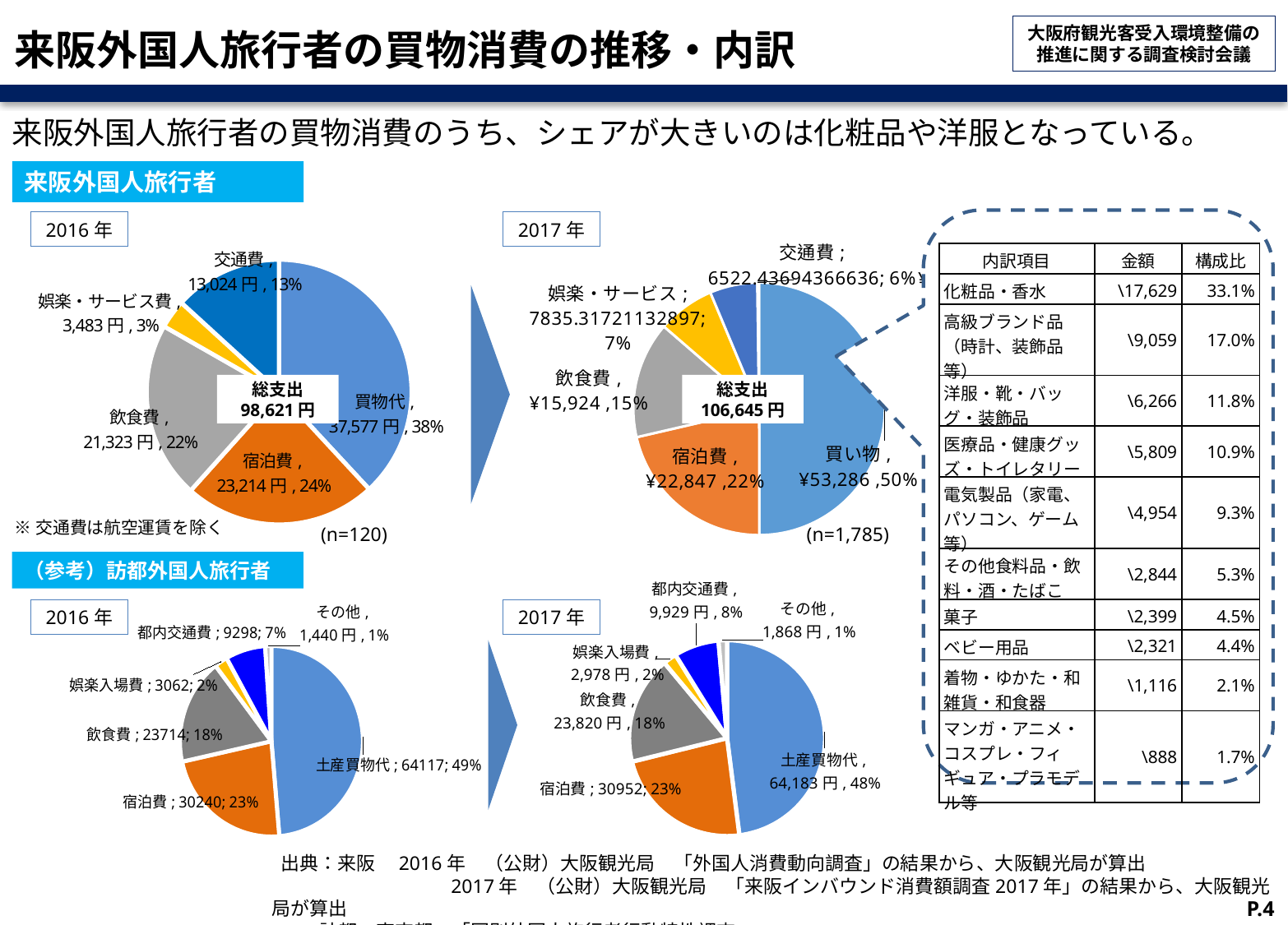
In the 訪都外国人旅行者 2017年 pie chart, what is the value shown for 飲食費? 23,820 円, 18% In the 来阪外国人旅行者 2016年 pie chart, which category has the largest share? 買物代 In the 来阪外国人旅行者 2016年 pie chart, how many categories are shown? 5 In the 来阪外国人旅行者 2016年 pie chart, what is the value shown for 買物代? 37,577 円, 38% In the 訪都外国人旅行者 2016年 pie chart, what is the value shown for 土産買物代? 64117; 49% In the 訪都外国人旅行者 2017年 pie chart, how many categories are shown? 6 In the 訪都外国人旅行者 2017年 pie chart, which is larger, 宿泊費 or 都内交通費? 宿泊費 In the 来阪外国人旅行者 2017年 pie chart, what is the value shown for 宿泊費? ¥22,847, 22% What type of chart is used for the 来阪外国人旅行者 2017年 data? Pie chart In the 来阪外国人旅行者 2017年 pie chart, what share does 買い物 account for? 50% In the 来阪外国人旅行者 2016年 pie chart, what is the 総支出 shown in the centre? 98,621 円 In the 来阪外国人旅行者 2017年 pie chart, which category has the smallest share? 交通費